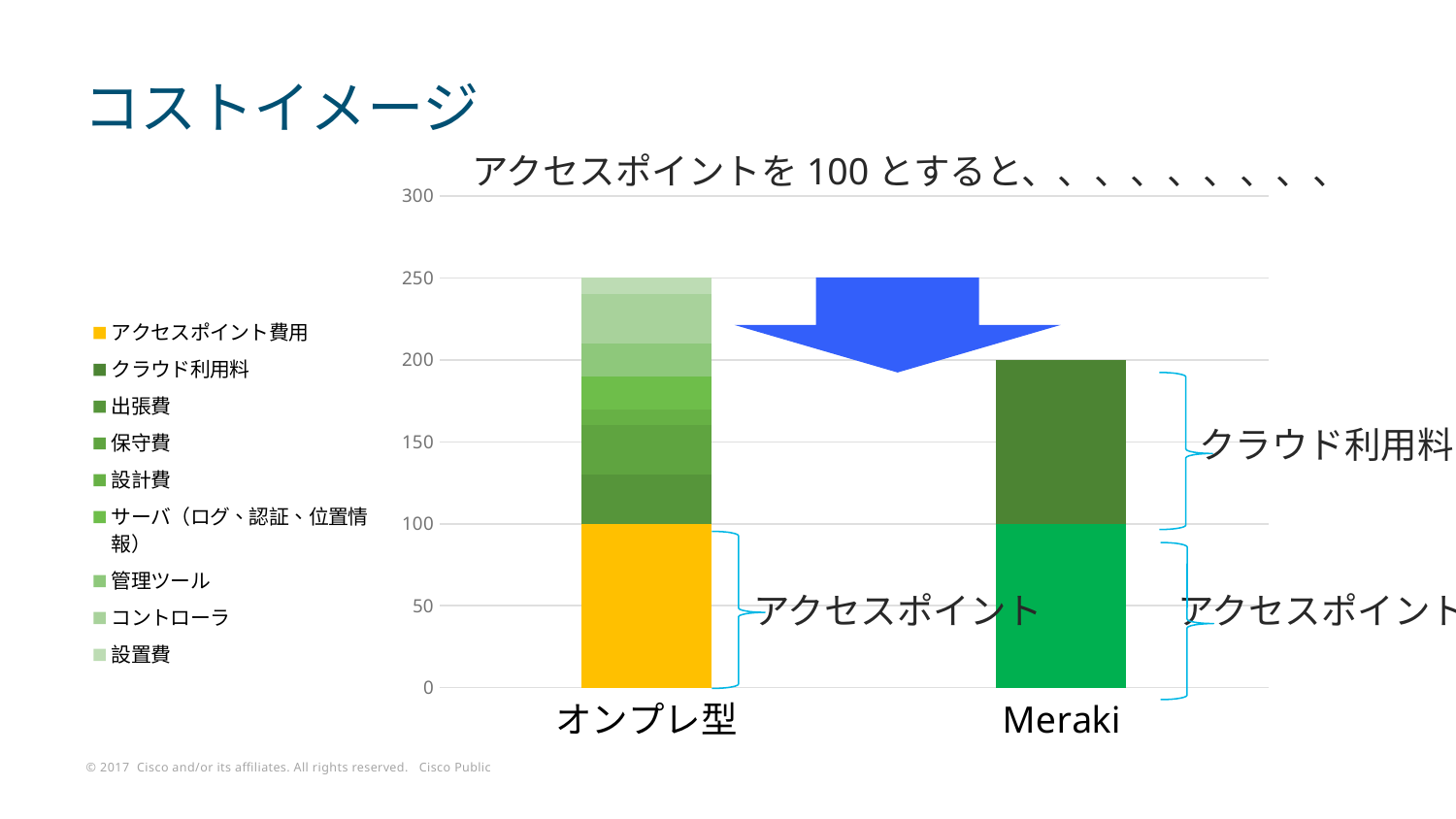
What is the total height of the stacked bar for オンプレ型? 250 What is the total height of the stacked bar for Meraki? 200 What kind of chart is shown on the slide? Stacked bar chart Is the total bar height for オンプレ型 greater or less than 200? greater What is the title of the chart? アクセスポイントを 100 とすると、、、、、、、、、、 What is the difference between the total bar heights of オンプレ型 and Meraki? 50 What is the value of the クラウド利用料 segment for Meraki? 100 Which category has the lowest total bar height? Meraki What is the value of the アクセスポイント費用 segment for Meraki? 100 Which category has the taller stacked bar, オンプレ型 or Meraki? オンプレ型 How many categories are shown on the x axis of the chart? 2 How many series does the chart's legend list? 9